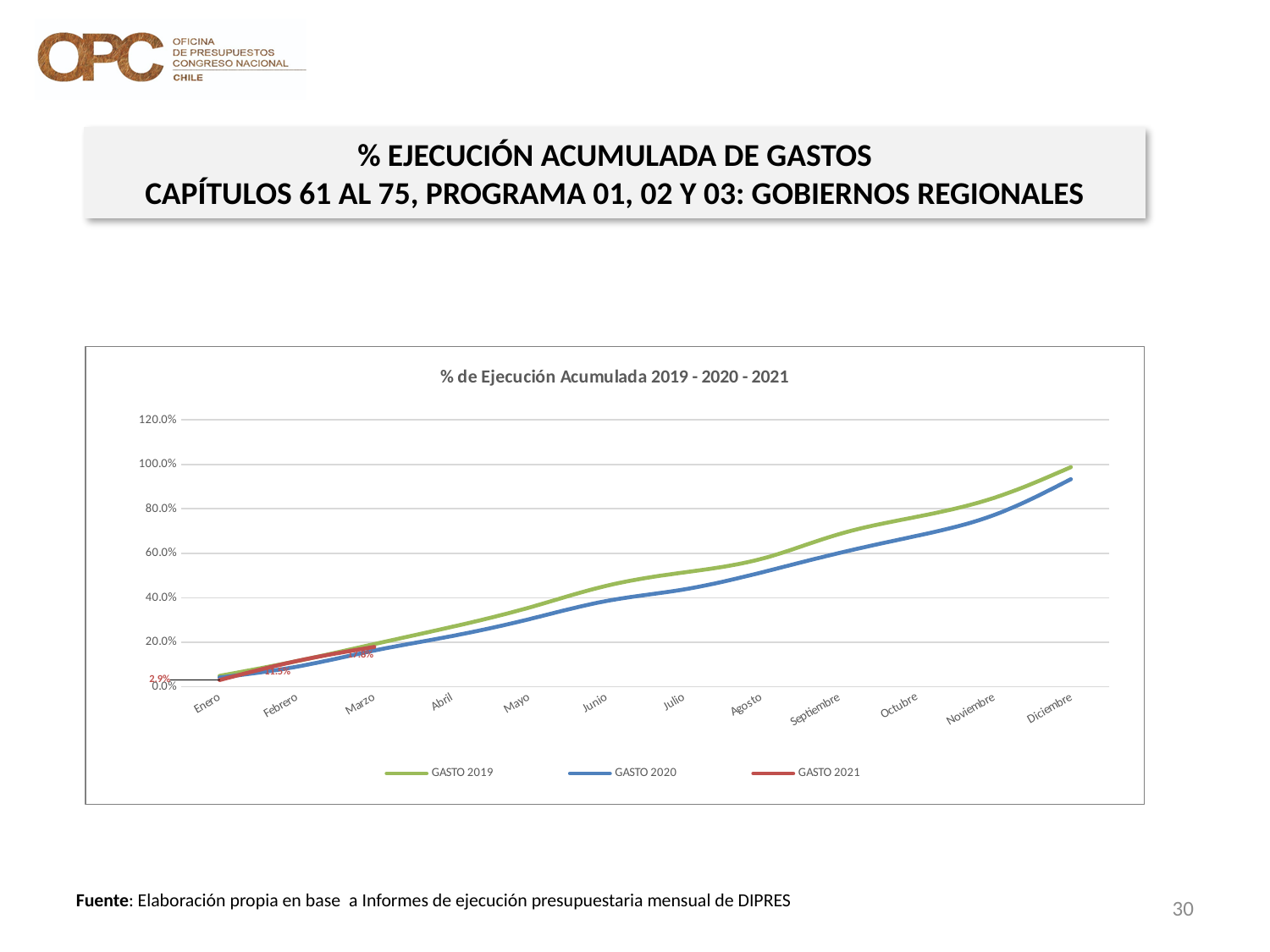
Is the value for GASTO 2020 in Agosto greater or less than 60.0%? less How many series does the chart legend list? 3 What kind of chart is shown on the slide? line chart What colour is the line for GASTO 2021? red Is the value for GASTO 2019 in Diciembre greater or less than 80.0%? greater How many months are shown along the x axis of the chart? 12 Is the value for GASTO 2021 in Marzo greater or less than 20.0%? less Which series reaches the highest value in Diciembre? GASTO 2019 What is the title of the chart? % de Ejecución Acumulada 2019 - 2020 - 2021 In Diciembre, which series has the higher value, GASTO 2019 or GASTO 2020? GASTO 2019 Do the values of GASTO 2019 rise or fall from Enero to Diciembre? rise What is the value of GASTO 2021 in Enero? 2.9%